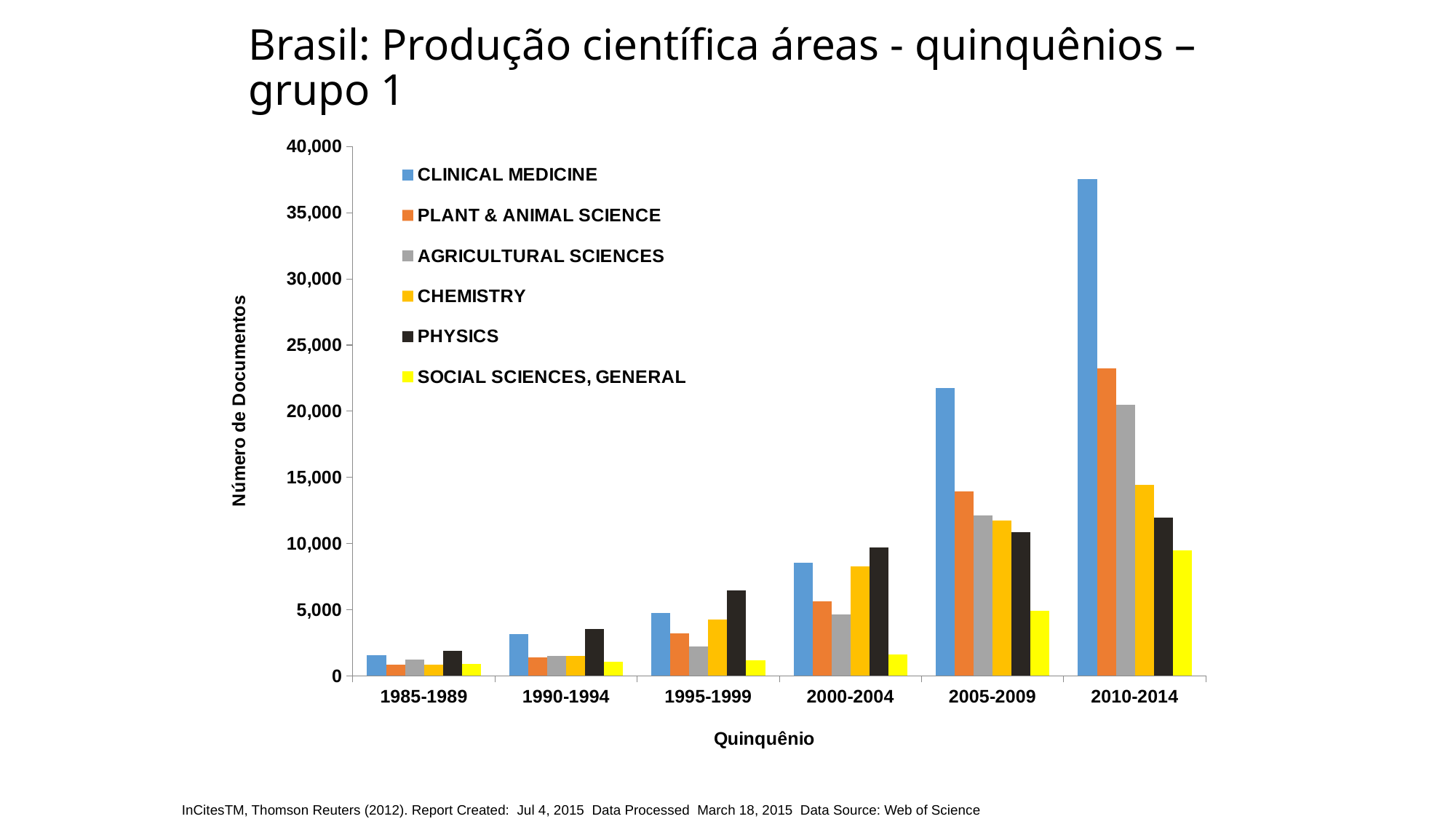
In the 1995-1999 period, which is larger: PHYSICS or CLINICAL MEDICINE? PHYSICS Which series has the highest value in the 2010-2014 period? CLINICAL MEDICINE Is the value for CLINICAL MEDICINE in 2010-2014 greater or less than 35,000? greater How many quinquennia (periods) are shown on the x axis? 6 Which series has the lowest value in the 2010-2014 period? SOCIAL SCIENCES, GENERAL What kind of chart is shown on the slide? Bar chart How many series does the legend list? 6 Which series has the highest value in the 2000-2004 period? PHYSICS Is the value for CHEMISTRY in 2005-2009 greater or less than 10,000? greater What is the title of the vertical axis? Número de Documentos Do the values for CLINICAL MEDICINE rise or fall from 1985-1989 to 2010-2014? rise Is the value for PLANT & ANIMAL SCIENCE in 2010-2014 greater or less than 20,000? greater